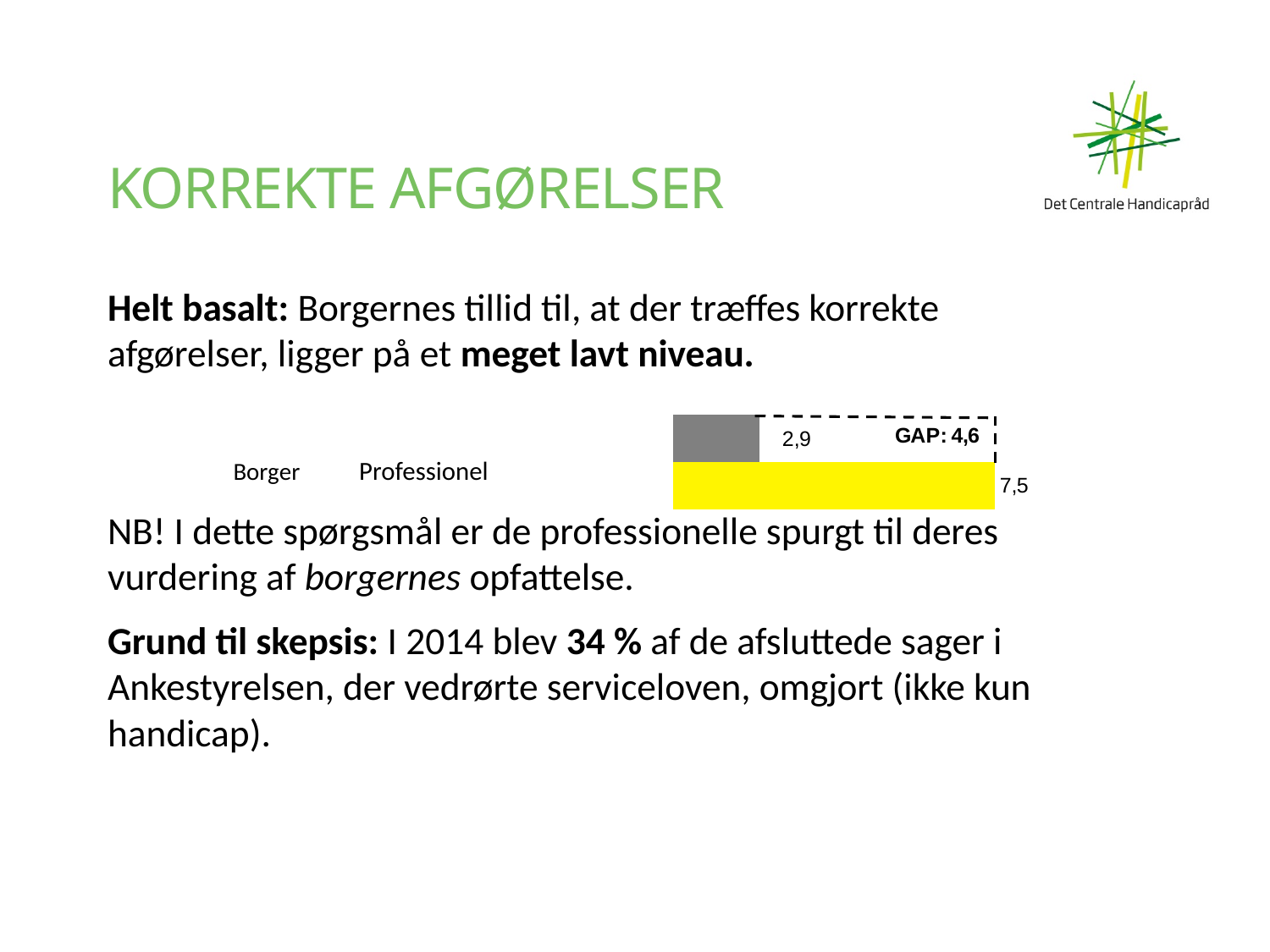
Which bar shows the highest value in the chart? the yellow bar (7,5) What value is printed on the grey bar of the chart? 2,9 What value is printed on the yellow bar of the chart? 7,5 Which two group labels are shown next to the chart? Borger and Professionel What colour is the bar with the value 7,5? yellow How many bars are plotted in the chart? 2 What is the difference between the yellow bar value and the grey bar value? 4,6 What gap value is annotated on the chart? GAP: 4,6 Which bar has the higher value, the grey bar or the yellow bar? the yellow bar Which bar shows the lowest value in the chart? the grey bar (2,9) What kind of chart is shown on the slide? bar chart